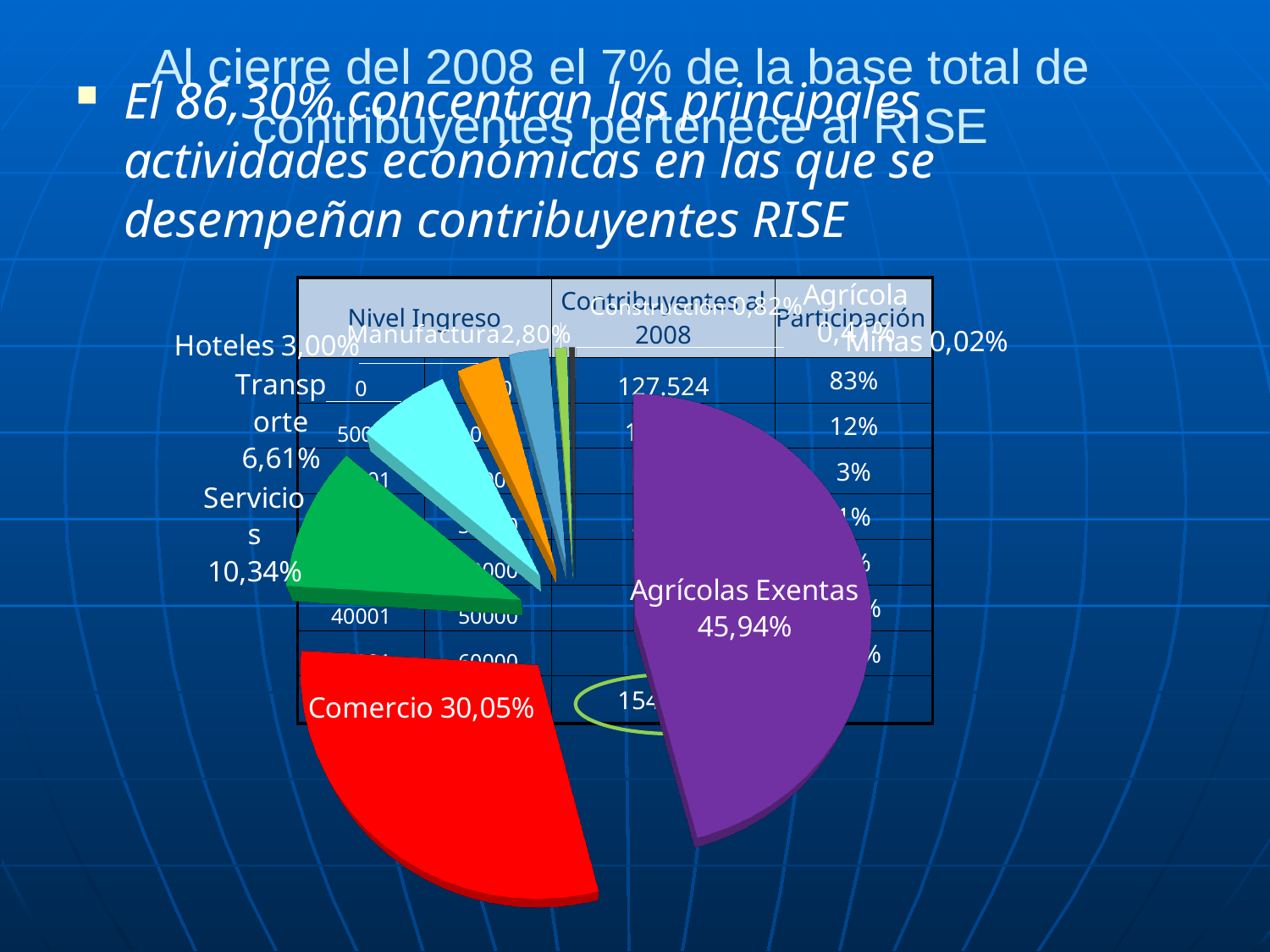
Which category has the smallest slice of the pie chart? Minas What is the value shown for Comercio in the pie chart? 30,05% Which slice is larger, Servicios or Transporte? Servicios What share of the pie does Agrícolas Exentas represent? 45,94% What is the value shown for Servicios in the pie chart? 10,34% Which category has the largest slice of the pie chart? Agrícolas Exentas What kind of chart is shown on the slide? pie chart What is the value shown for Hoteles in the pie chart? 3,00% What is the value shown for Manufactura in the pie chart? 2,80% How many slices does the pie chart have? 9 What is the difference between the Agrícolas Exentas and Comercio slices? 15,89% What is the value shown for Transporte in the pie chart? 6,61%